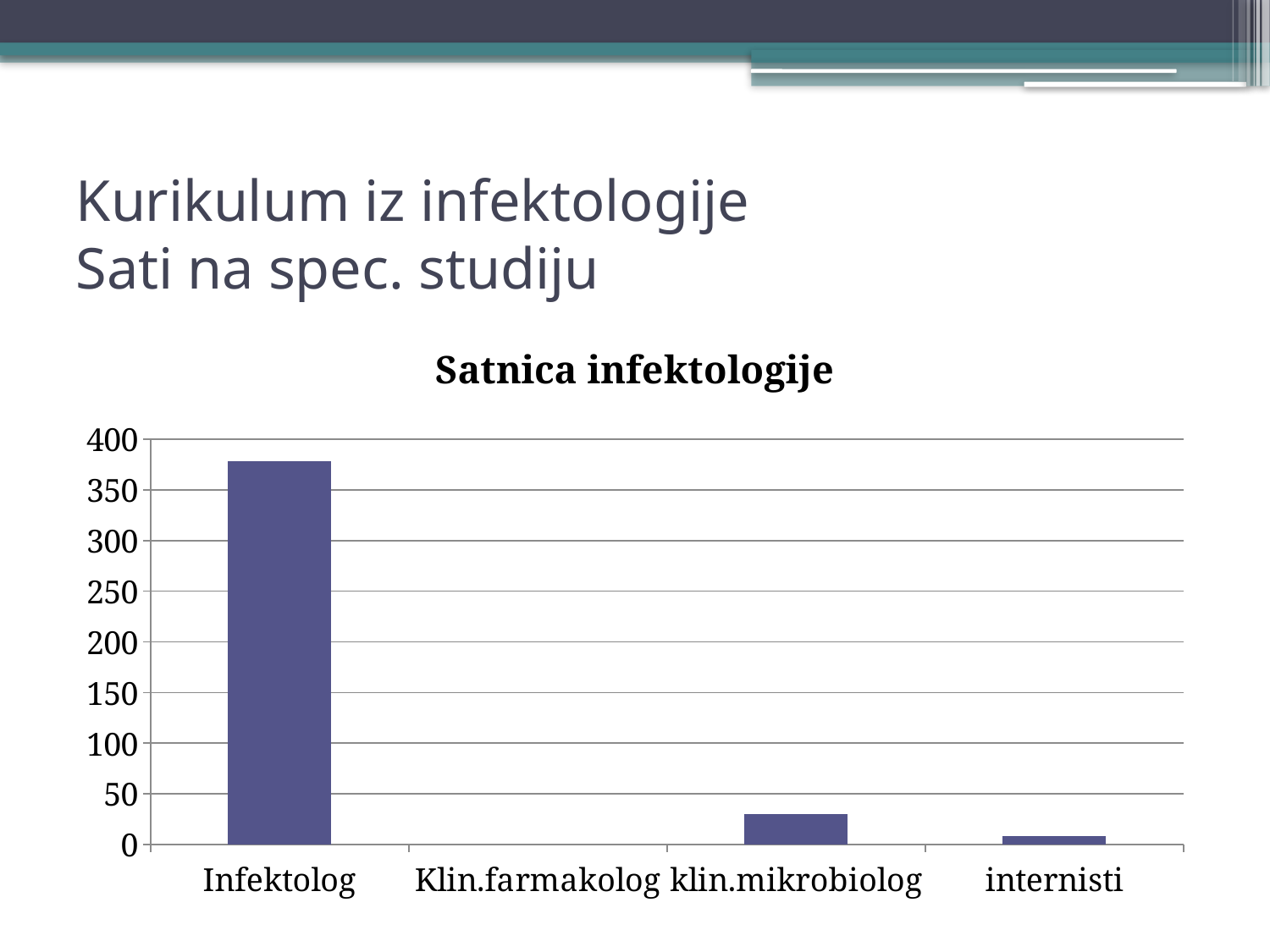
Which category has the highest value in the chart? Infektolog Is the value for Infektolog greater or less than 350? greater How many categories are shown on the x axis of the chart? 4 Which is larger, the value for klin.mikrobiolog or the value for internisti? klin.mikrobiolog What is the title of the chart? Satnica infektologije Is the value for Infektolog greater or less than 400? less Which is larger, the value for Infektolog or the value for klin.mikrobiolog? Infektolog What is the highest value shown on the vertical axis of the chart? 400 What kind of chart is shown on the slide? bar chart Is the value for klin.mikrobiolog greater or less than 50? less